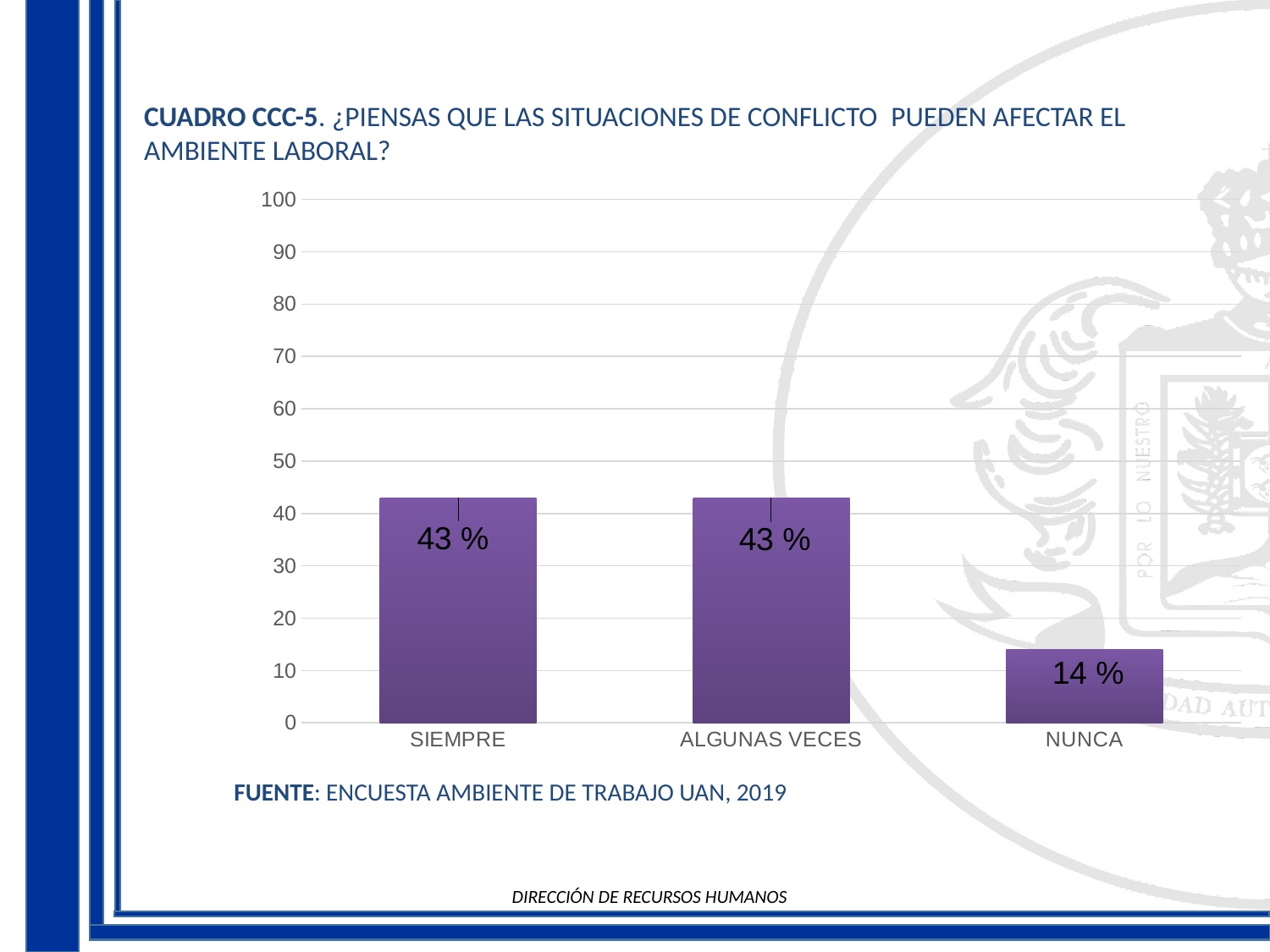
What is the difference between the values for SIEMPRE and NUNCA? 29 % What is the value for NUNCA? 14 % What is the value for ALGUNAS VECES? 43 % What source is cited below the chart? ENCUESTA AMBIENTE DE TRABAJO UAN, 2019 What is the highest value shown on the y axis? 100 What is the value for SIEMPRE? 43 % What kind of chart is shown on the slide? bar chart Is the value for NUNCA greater or less than 20? less Is the value for SIEMPRE greater or less than 40? greater Which is larger, the value for ALGUNAS VECES or the value for NUNCA? ALGUNAS VECES Which category has the lowest value? NUNCA How many categories are shown on the x axis? 3